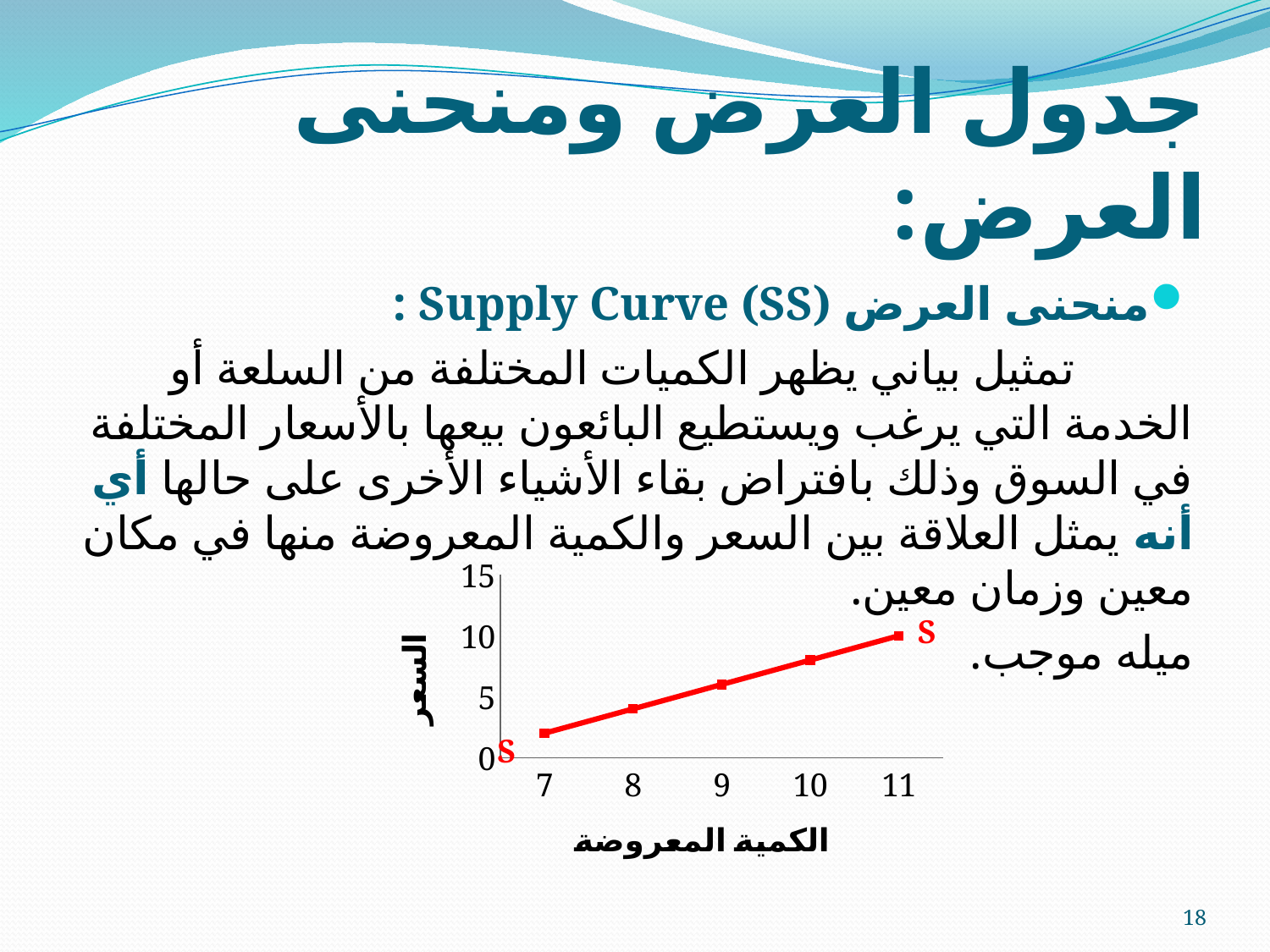
Is the price at quantity 7 greater or less than 5? less What is the title of the x axis of the chart? الكمية المعروضة Is the price at quantity 11 greater or less than 5? greater Which is larger, the price at quantity 8 or the price at quantity 11? quantity 11 How many data points are plotted on the supply curve? 5 Is the price at quantity 10 greater or less than 10? less Do the values on the supply curve rise or fall as the quantity supplied increases along the x axis? rise At which quantity on the x axis is the price highest? 11 What kind of chart is shown on the slide? line chart At which quantity on the x axis is the price lowest? 7 What colour is the supply curve line in the chart? red